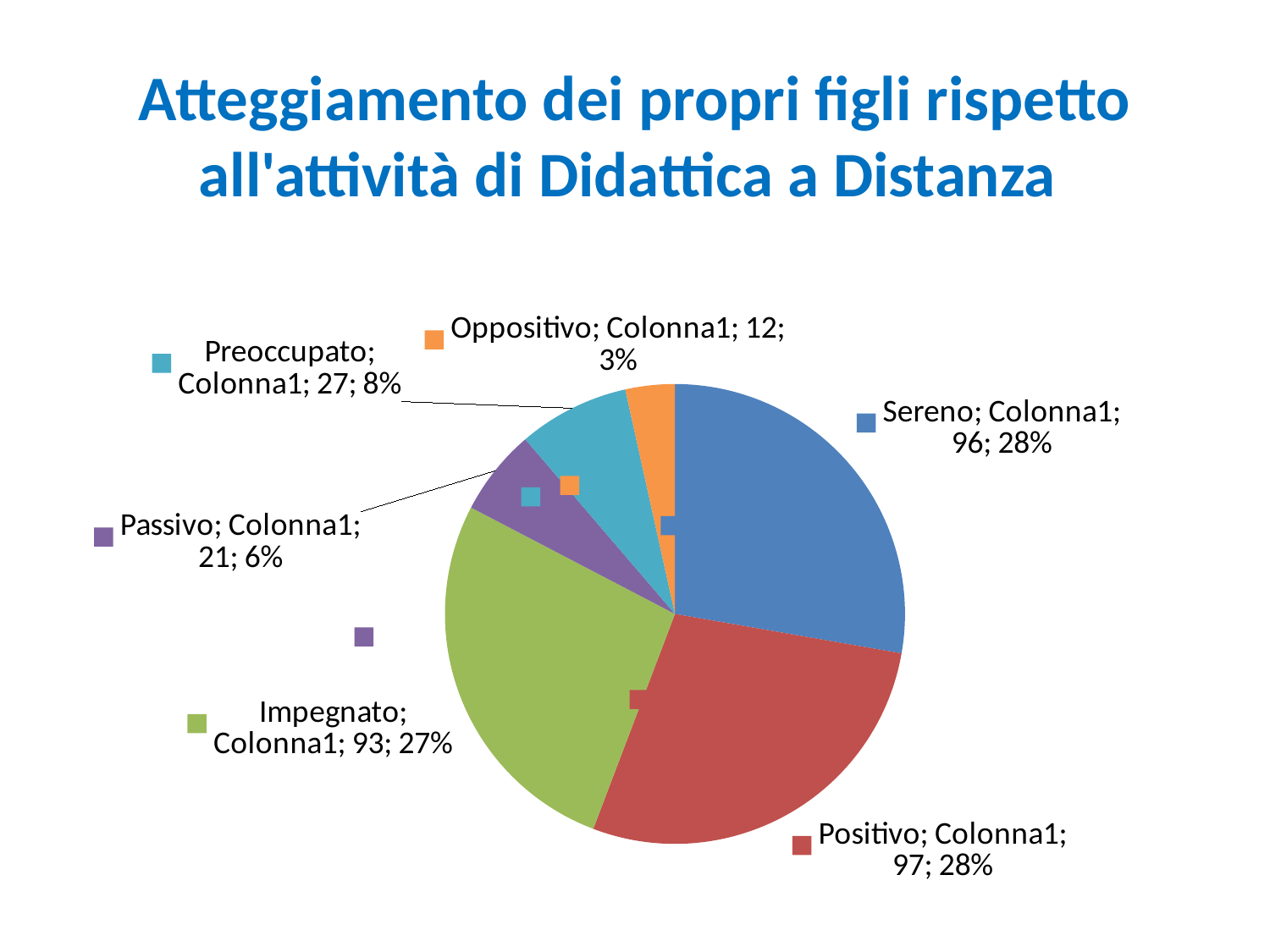
What is the value for Positivo? 97 What share of the pie does Passivo represent? 6% What is the value for Impegnato? 93 How many slices does the pie chart have? 6 What is the title of the chart? Atteggiamento dei propri figli rispetto all'attività di Didattica a Distanza What type of chart is shown on the slide? pie chart What share of the pie does Preoccupato represent? 8% Which is larger, the value for Impegnato or the value for Preoccupato? Impegnato What is the value for Oppositivo? 12 Which category has the smallest slice? Oppositivo What is the value for Sereno? 96 What is the difference between the values for Preoccupato and Passivo? 6